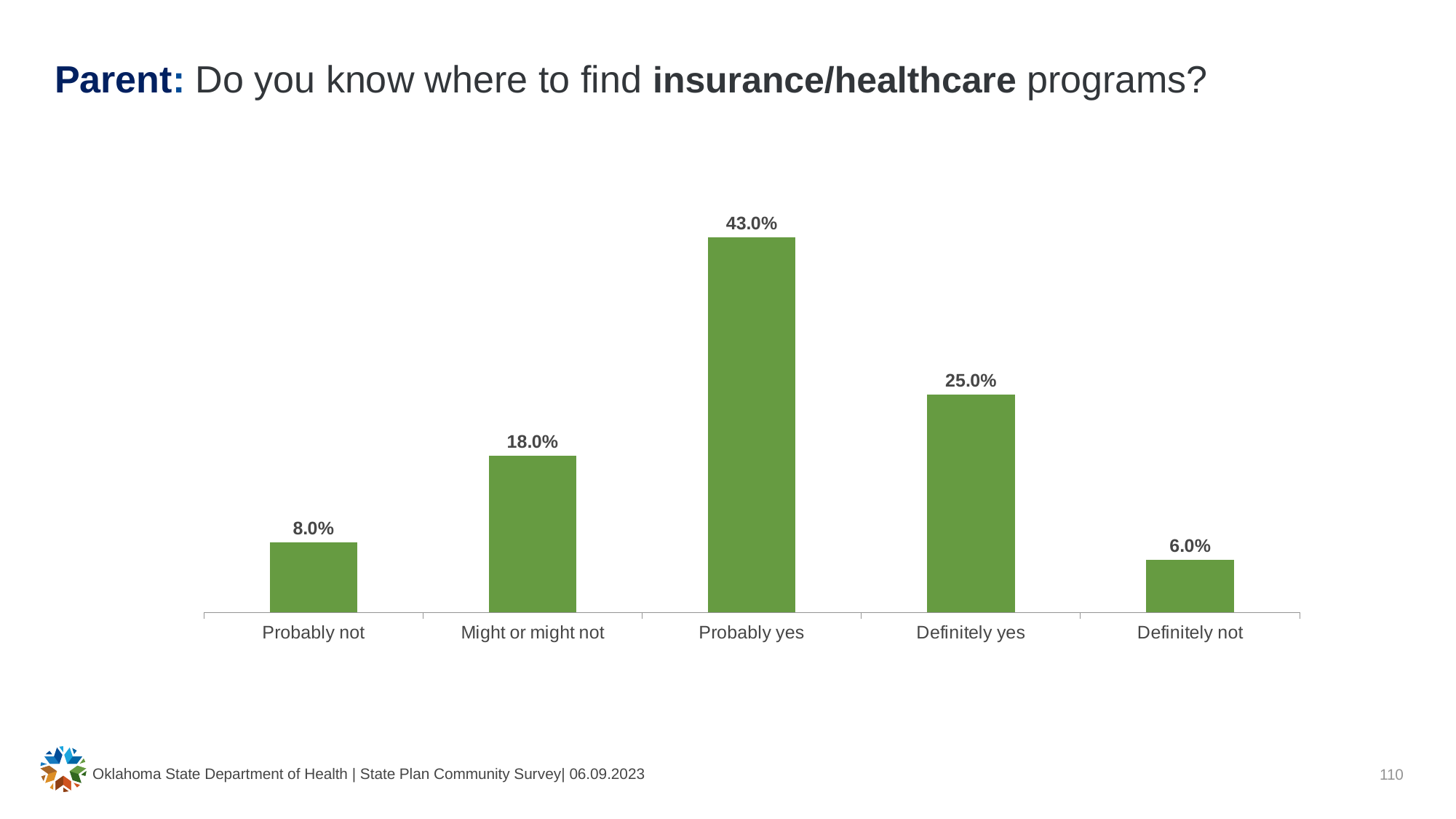
What is the value for "Definitely not"? 6.0% What kind of chart is shown on the slide? Bar chart Which response category has the lowest value? Definitely not What colour are the bars in the chart? Green What is the value for "Definitely yes"? 25.0% How many response categories are shown in the chart? 5 Which is larger, "Might or might not" or "Definitely yes"? Definitely yes What is the value for "Might or might not"? 18.0% What is the difference between "Probably not" and "Definitely not"? 2.0% What is the difference between "Probably yes" and "Definitely yes"? 18.0% Which response category has the highest value? Probably yes What percentage of parents answered "Probably yes"? 43.0%